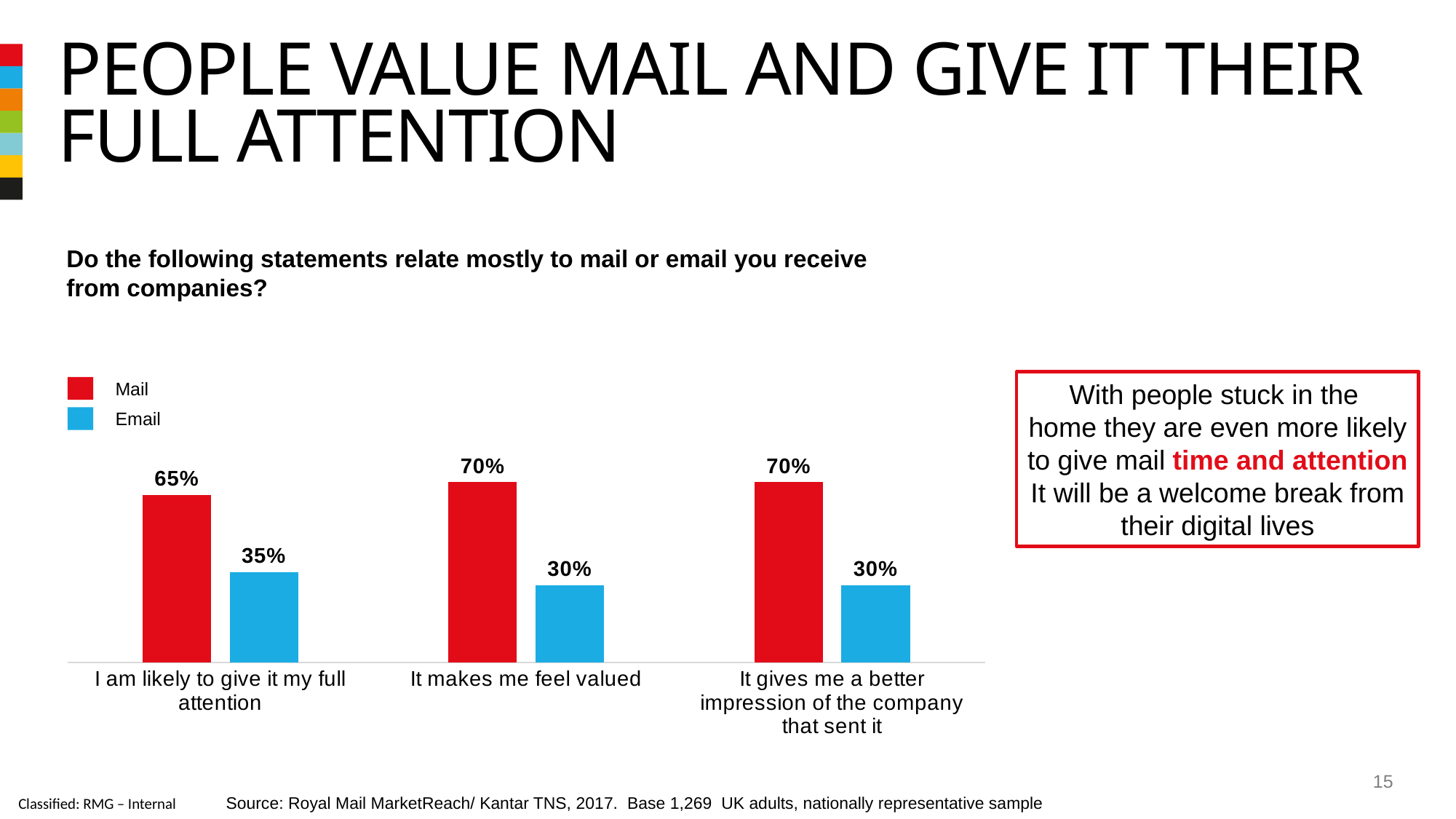
What kind of chart is shown on the slide? Bar chart What is the Email value for "I am likely to give it my full attention"? 35% Which category has the lowest Email value? It makes me feel valued and It gives me a better impression of the company that sent it (both 30%) What is the Email value for "It makes me feel valued"? 30% How many series does the legend list? 2 Which category has the lowest Mail value? I am likely to give it my full attention What is the Mail value for "I am likely to give it my full attention"? 65% How many categories are shown on the x axis of the chart? 3 For "It gives me a better impression of the company that sent it", which is larger, Mail or Email? Mail What is the difference between the Mail and Email values for "It makes me feel valued"? 40 percentage points What is the difference between the Mail and Email values for "I am likely to give it my full attention"? 30 percentage points What is the Mail value for "It gives me a better impression of the company that sent it"? 70%